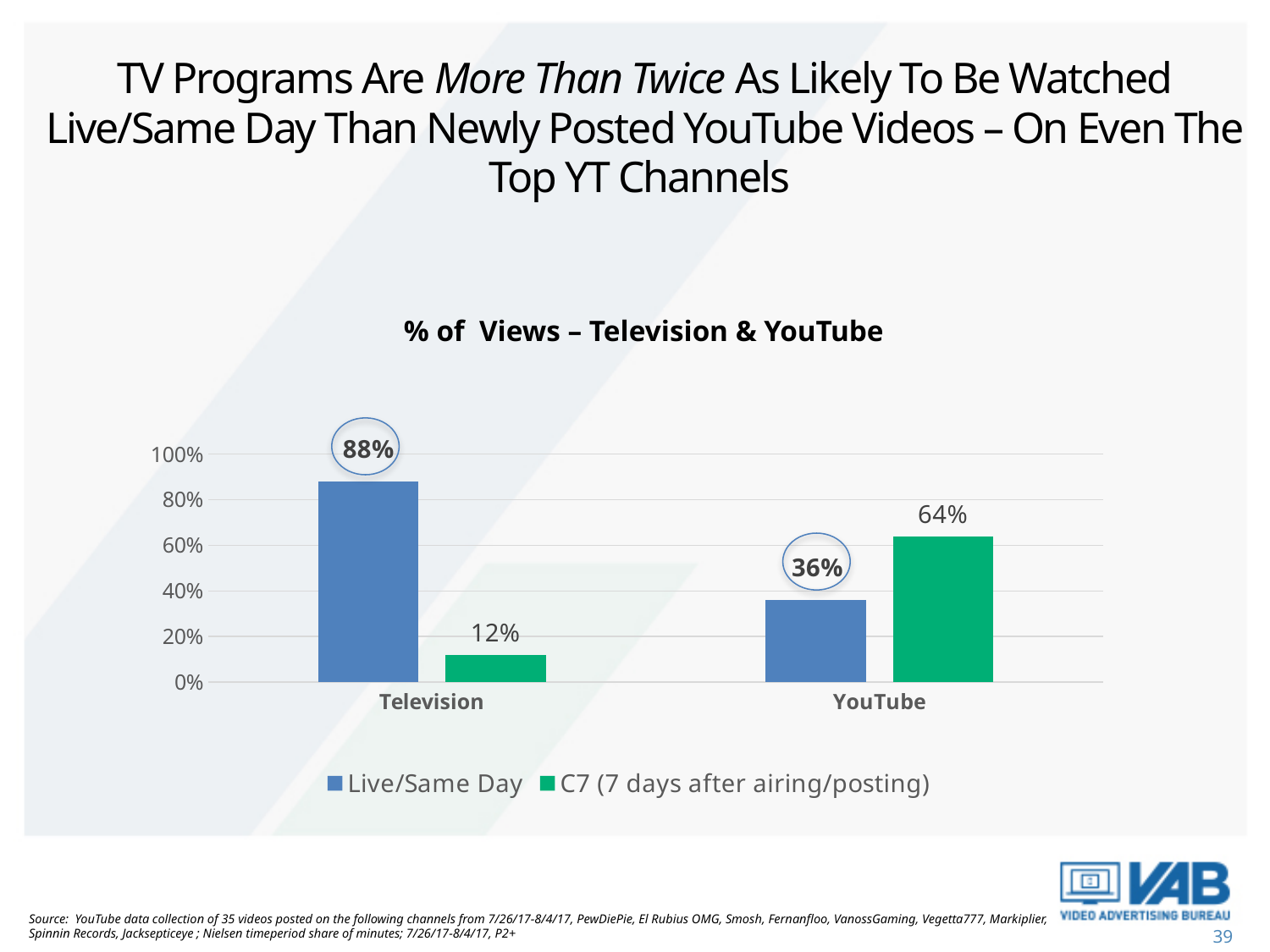
What is the difference between the C7 and Live/Same Day values for YouTube? 28% Which category has the lowest C7 (7 days after airing/posting) value? Television What is the difference between the Live/Same Day values for Television and YouTube? 52% How many series does the legend list? 2 What is the Live/Same Day value for YouTube? 36% What is the C7 (7 days after airing/posting) value for YouTube? 64% What is the C7 (7 days after airing/posting) value for Television? 12% What type of chart is shown? Bar chart What is the title of the chart? % of Views – Television & YouTube How many categories are shown on the x axis? 2 What is the Live/Same Day value for Television? 88% Which category has the higher Live/Same Day value, Television or YouTube? Television